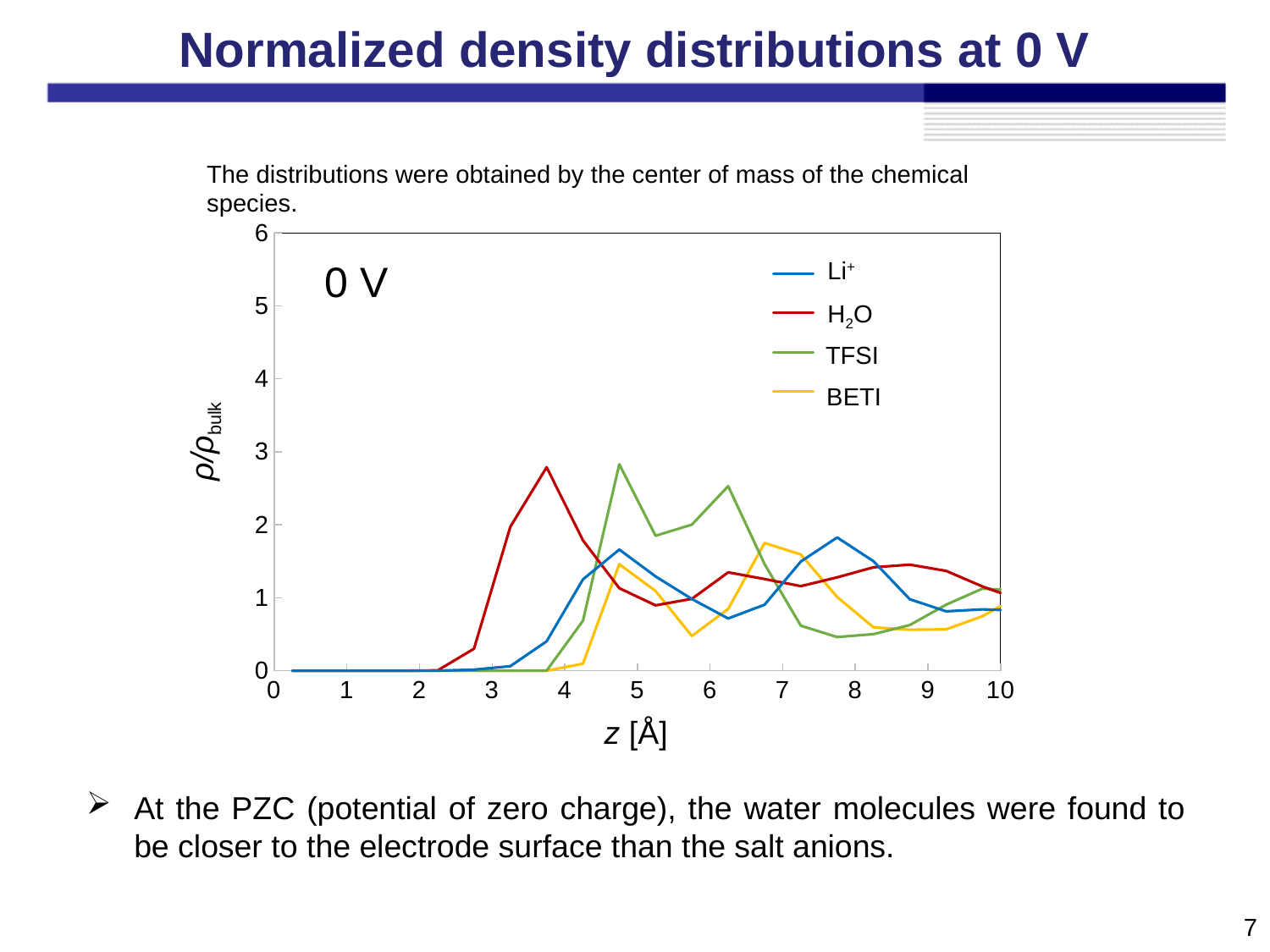
Is the peak value of the BETI series greater or less than 2? less Is the peak value of the Li+ series greater or less than 2? less What kind of chart is shown on the slide? line chart Which series is the first to rise above zero as z increases? H2O Is the peak of the H2O series located at a smaller or larger z than the first peak of the TFSI series? smaller How many series does the legend list? 4 Is the peak value of the H2O series greater or less than 2? greater What is the label of the x axis? z [Å] What is the value of the Li+ series at z = 1? 0 Which series is drawn in red? H2O Which series is the last to rise above zero as z increases? BETI